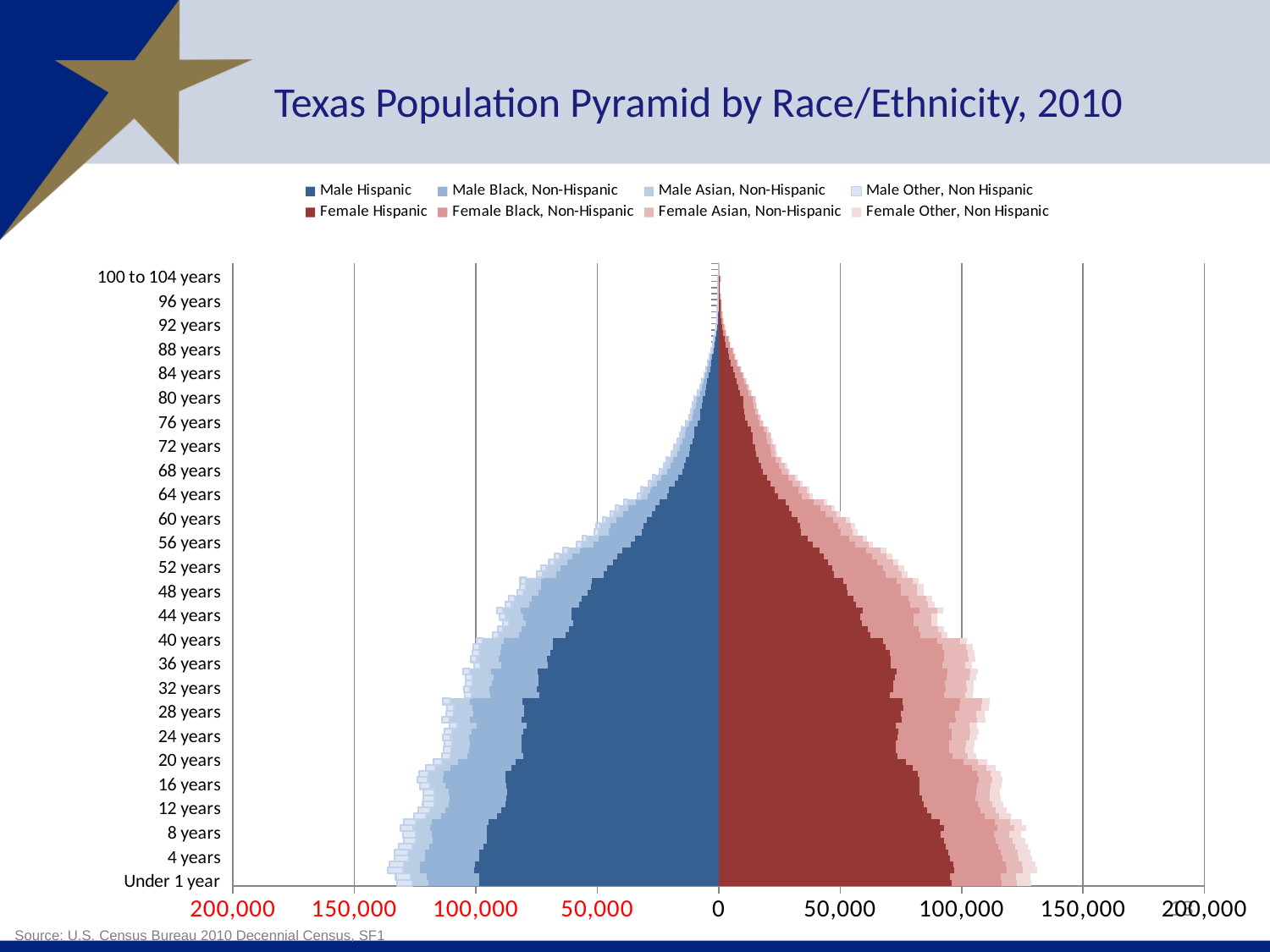
Which age group has a larger total male population, 'Under 1 year' or '80 years'? Under 1 year Is the total male population for the '80 years' age group greater or less than 50,000? less Is the total female population for the '80 years' age group greater or less than 50,000? less Is the total male population for the '16 years' age group greater or less than 100,000? greater What is the title of the chart? Texas Population Pyramid by Race/Ethnicity, 2010 What kind of chart is shown on the slide? Bar chart (population pyramid) How many series does the legend list? 8 As age increases from 40 years to 100 to 104 years, do the bars generally get longer or shorter? Shorter Which side of the chart, left or right, shows the female series? Right